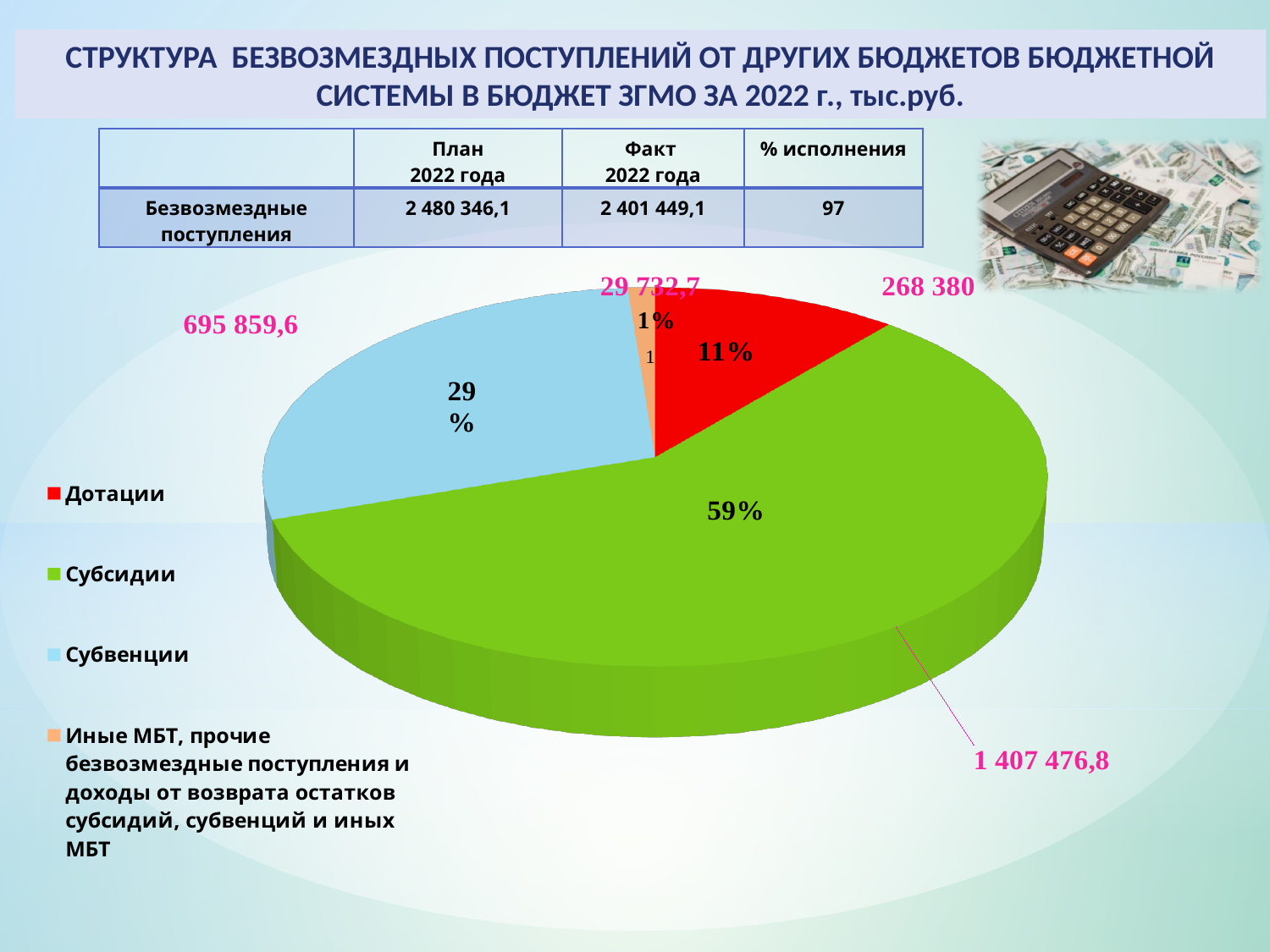
What share of the pie does Субсидии take? 59% How many entries does the legend of the pie chart list? 4 Which colour represents Субвенции in the pie chart? light blue What share of the pie does Субвенции take? 29% How many slices does the pie chart have? 4 What value is labelled for the Субсидии slice? 1 407 476,8 Which category has the largest slice of the pie? Субсидии What share of the pie does Дотации take? 11% What kind of chart is shown on the slide? pie chart What value is labelled for the Дотации slice? 268 380 What value is labelled for the Субвенции slice? 695 859,6 Which category has the smallest slice of the pie? Иные МБТ, прочие безвозмездные поступления и доходы от возврата остатков субсидий, субвенций и иных МБТ